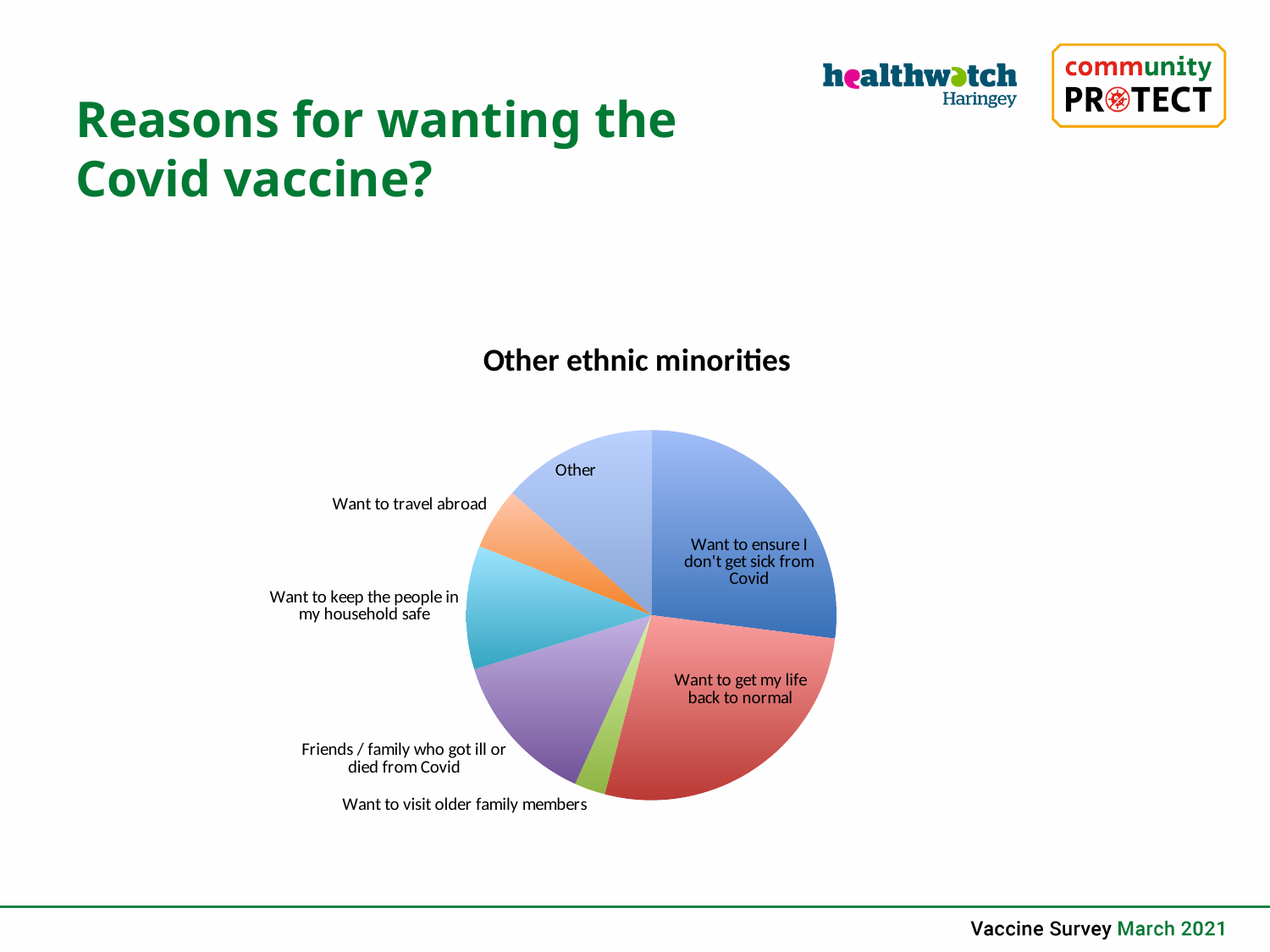
Which slice is larger: 'Friends / family who got ill or died from Covid' or 'Want to visit older family members'? Friends / family who got ill or died from Covid How many slices does the pie chart have? 7 What kind of chart is shown on the slide? Pie chart What colour is the 'Want to travel abroad' slice in the pie chart? Orange Which slice is larger: 'Other' or 'Want to visit older family members'? Other Which reason has the smallest slice in the pie chart? Want to visit older family members What is the title of the pie chart? Other ethnic minorities Which slice is larger: 'Want to travel abroad' or 'Want to keep the people in my household safe'? Want to keep the people in my household safe